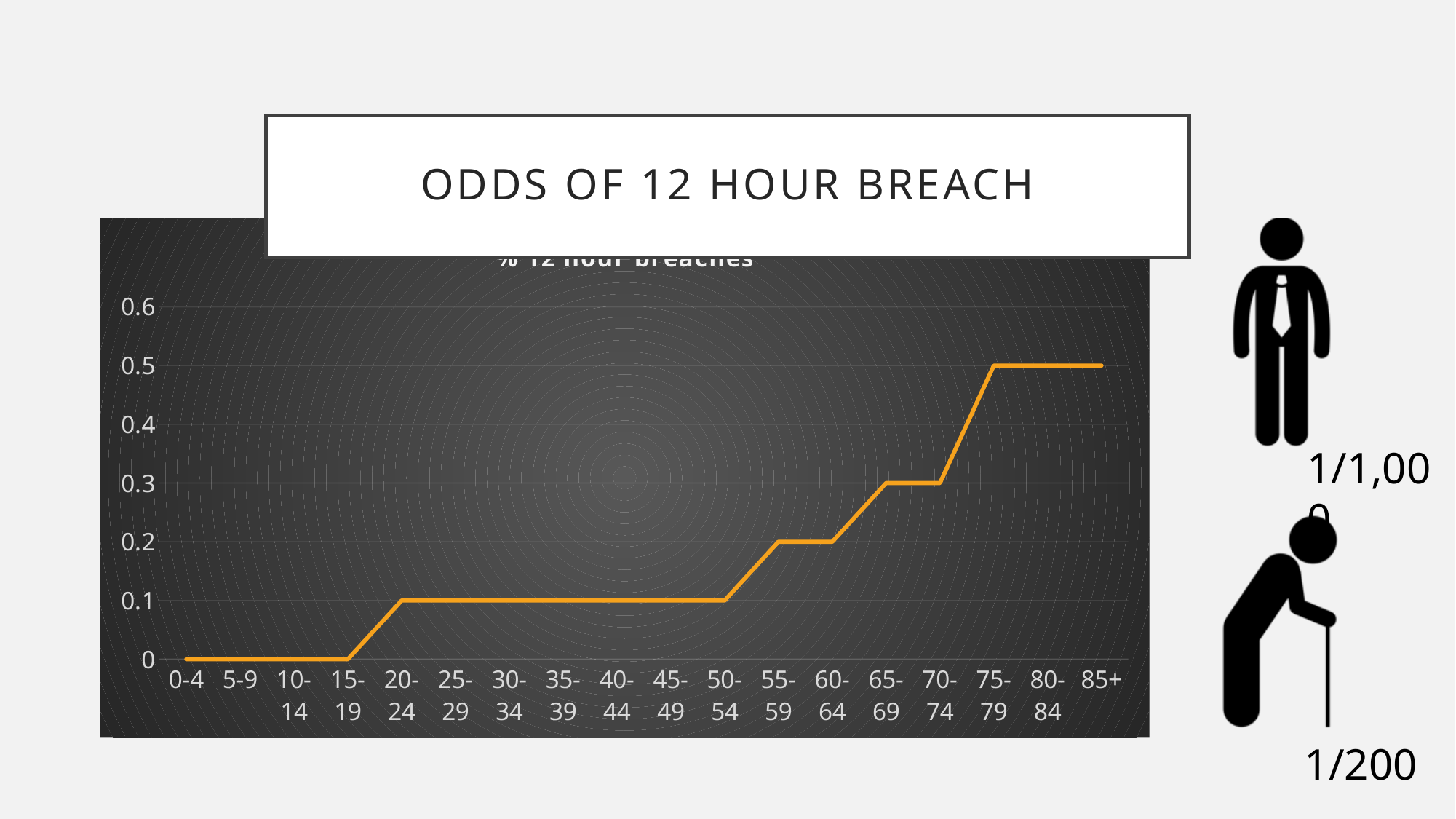
Which age group is the first to reach the highest plotted value of 0.5? 75-79 What is the difference between the values for the 75-79 and 70-74 age groups? 0.2 What is the value plotted for the 85+ age group? 0.5 What is the value plotted for the 70-74 age group? 0.3 What is the title shown in the box above the chart? ODDS OF 12 HOUR BREACH What kind of chart is shown on the slide? line chart Do the plotted values generally rise or fall as age increases along the x axis? rise What is the value plotted for the 30-34 age group? 0.1 How many age-group categories are shown on the x axis of the chart? 18 What is the value plotted for the 0-4 age group? 0 What is the value plotted for the 60-64 age group? 0.2 Which has the larger value, the 55-59 age group or the 45-49 age group? 55-59